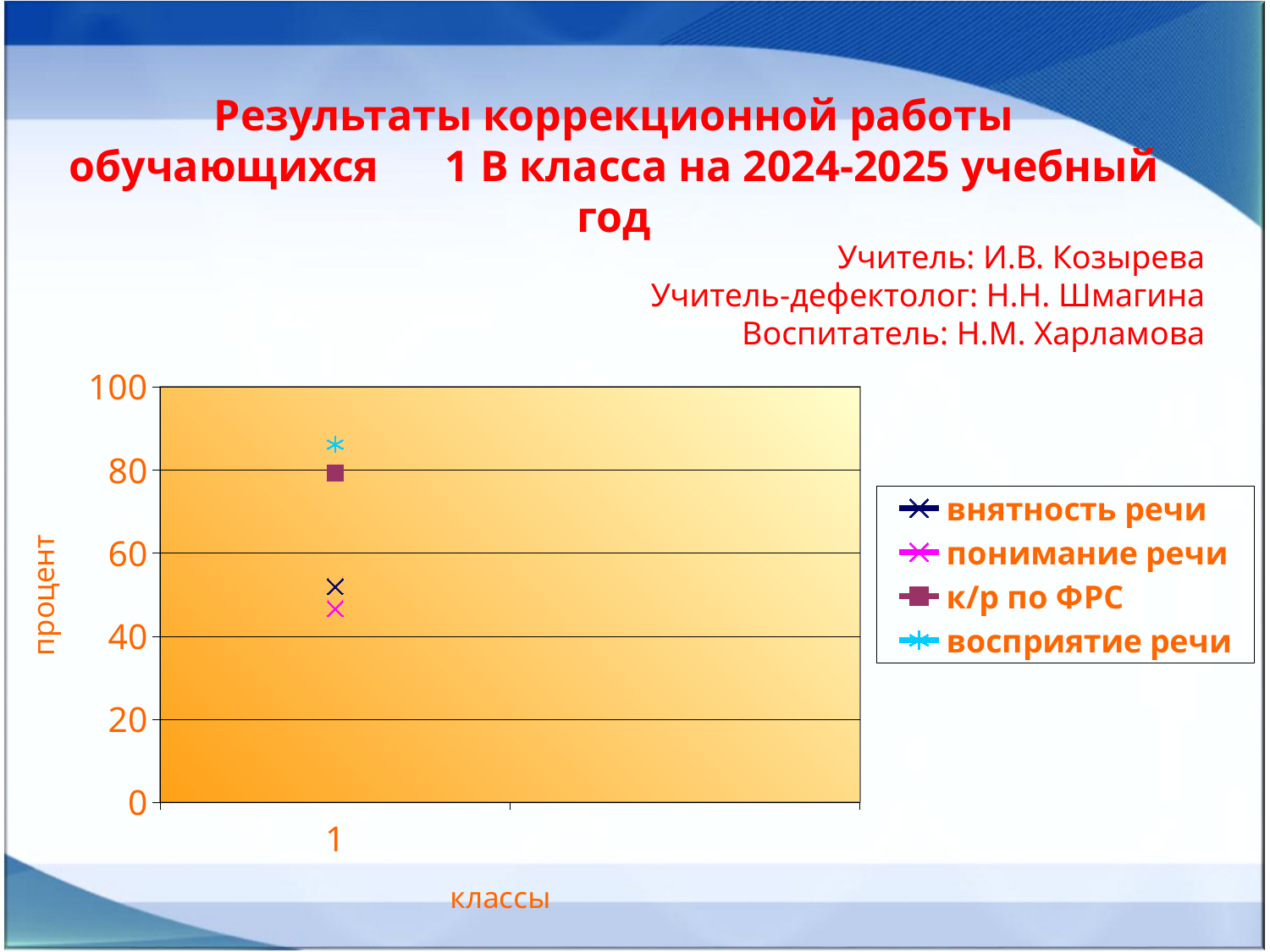
What is the label of the horizontal axis? классы Is the value for восприятие речи greater or less than 80? greater Which series has the lowest value for class 1? понимание речи Which is larger, the value for внятность речи or the value for понимание речи? внятность речи Which series has the highest value for class 1? восприятие речи How many categories are shown on the x axis? 1 How many series does the legend list? 4 Is the value for к/р по ФРС greater or less than 60? greater Is the value for понимание речи greater or less than 40? greater What is the label of the vertical axis? процент What kind of chart is shown on the slide? line chart